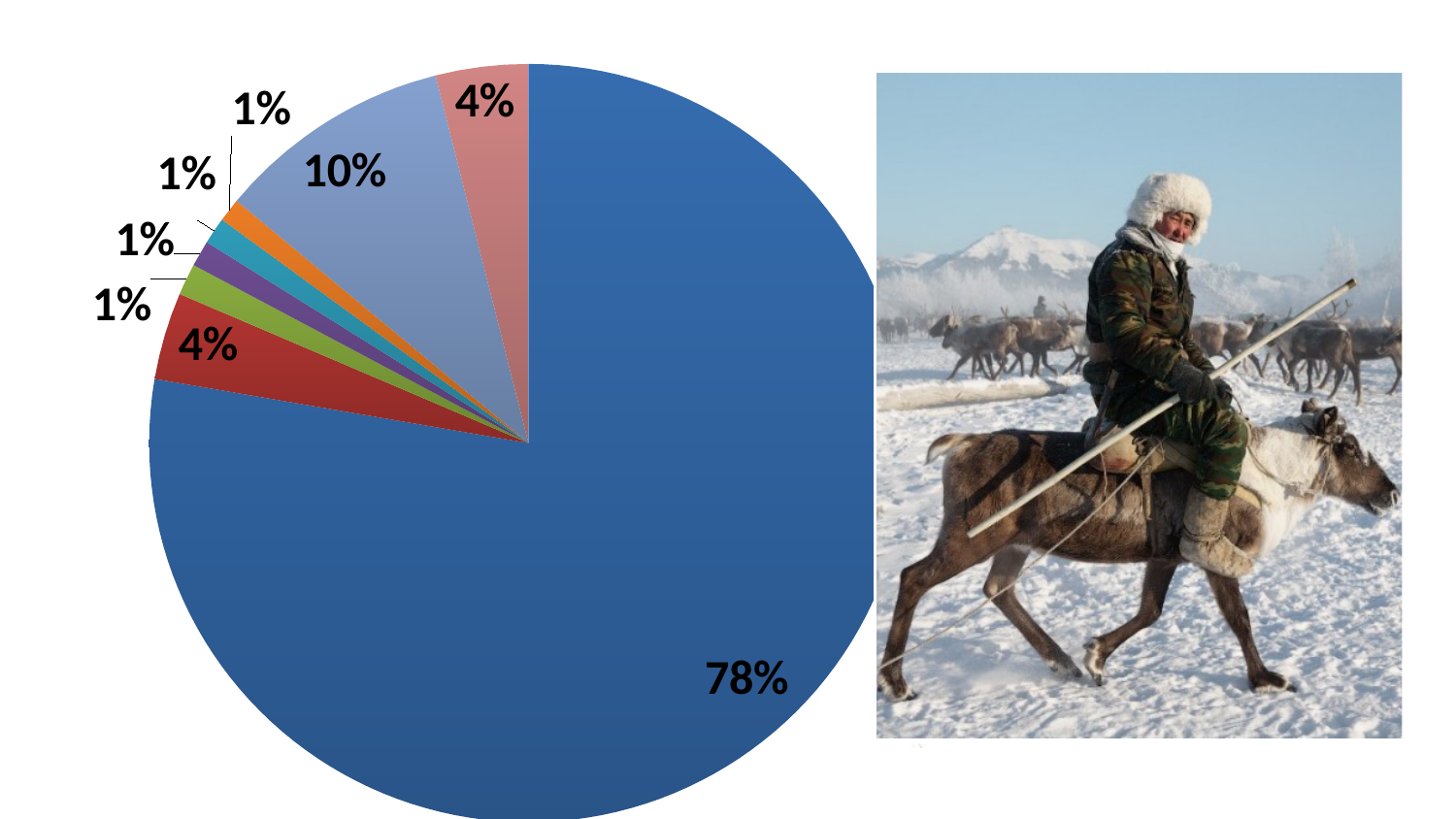
What percentage is shown for the light blue slice of the pie chart? 10% What percentage is shown for the dark blue slice of the pie chart? 78% What is the value of the largest slice of the pie chart? 78% What kind of chart is shown on the slide? pie chart How many slices does the pie chart have? 8 What is the value of the smallest slices of the pie chart? 1% Which is larger, the light blue slice or the red slice? the light blue slice What percentage is shown for the pink slice at the top of the pie chart? 4% How many slices of the pie chart are labelled 1%? 4 What colour is the largest slice of the pie chart? dark blue What percentage is shown for the red slice of the pie chart? 4% What is the difference between the largest slice (78%) and the light blue slice (10%)? 68%